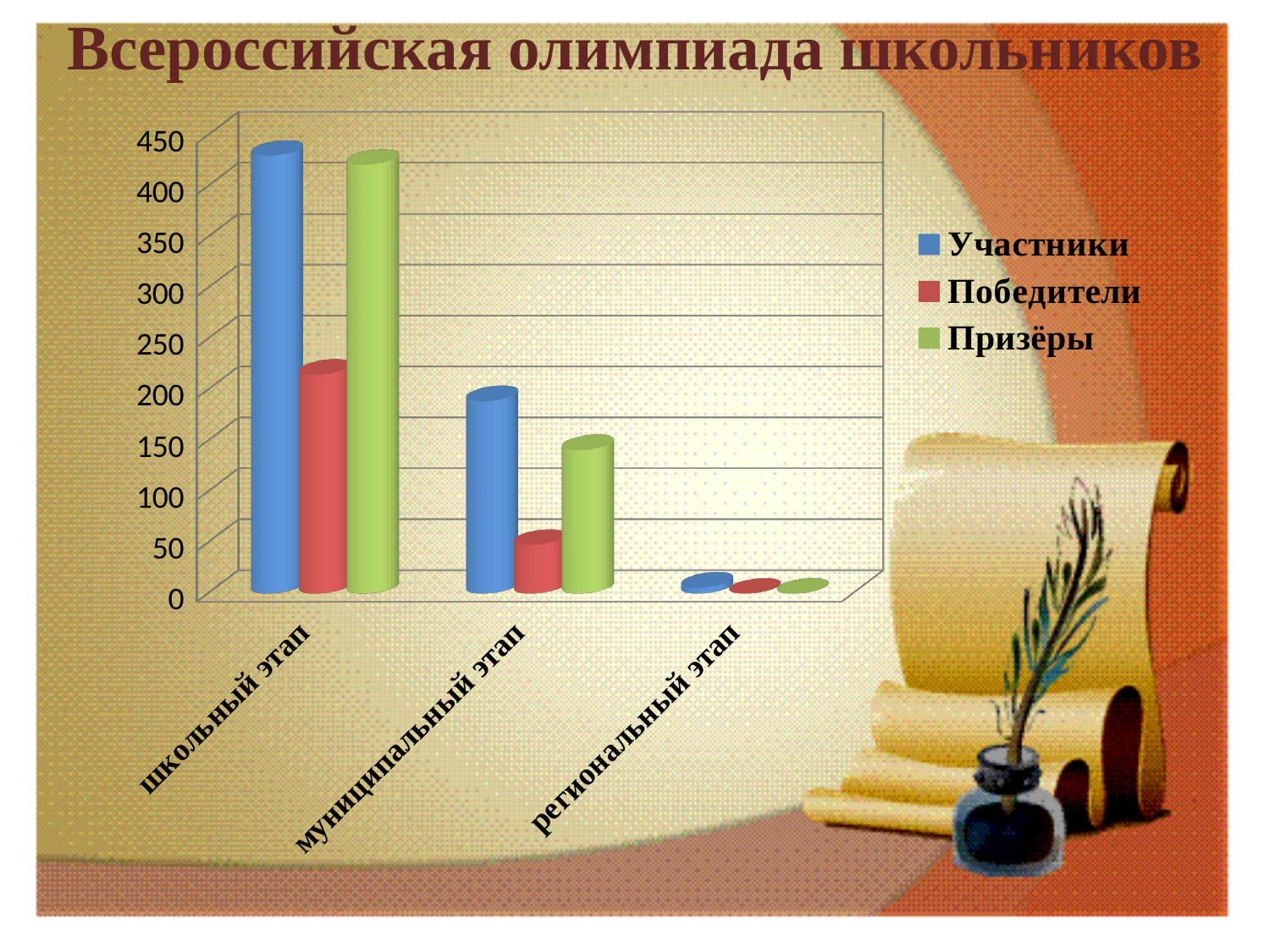
What is the title of the slide? Всероссийская олимпиада школьников Is the value for Победители at муниципальный этап greater or less than 100? less How many categories are shown on the x axis? 3 Is the value for Призёры at муниципальный этап greater or less than 100? greater Do the values for Участники rise or fall from школьный этап to региональный этап? fall Which category has the highest value for Участники? школьный этап What kind of chart is shown on the slide? bar chart At муниципальный этап, which is larger: Участники or Победители? Участники Which category has the lowest value for Призёры? региональный этап Which colour represents the series Победители? red Is the value for Участники at школьный этап greater or less than 400? greater How many series does the legend list? 3